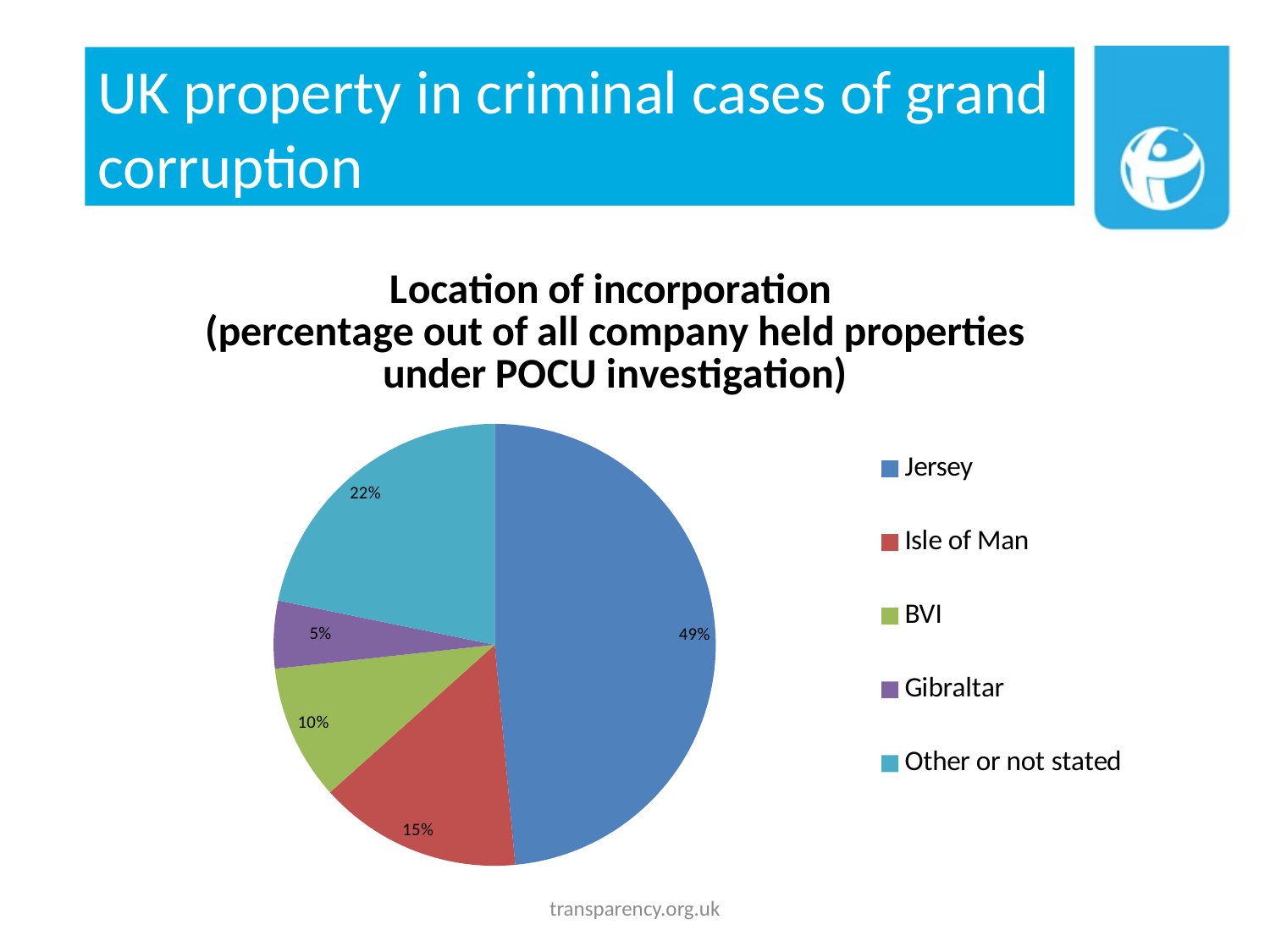
Which location has the smallest share of the pie chart? Gibraltar Which has a larger share, BVI or Other or not stated? Other or not stated What percentage of the pie chart is Isle of Man? 15% How many slices does the pie chart have? 5 What is the difference in percentage points between Jersey and Isle of Man? 34 What percentage of the pie chart is Gibraltar? 5% What colour is the Isle of Man slice in the pie chart? Red Which location has the largest share of the pie chart? Jersey What percentage of the pie chart is Jersey? 49% What percentage of the pie chart is BVI? 10% What type of chart is shown on the slide? Pie chart What percentage of the pie chart is Other or not stated? 22%